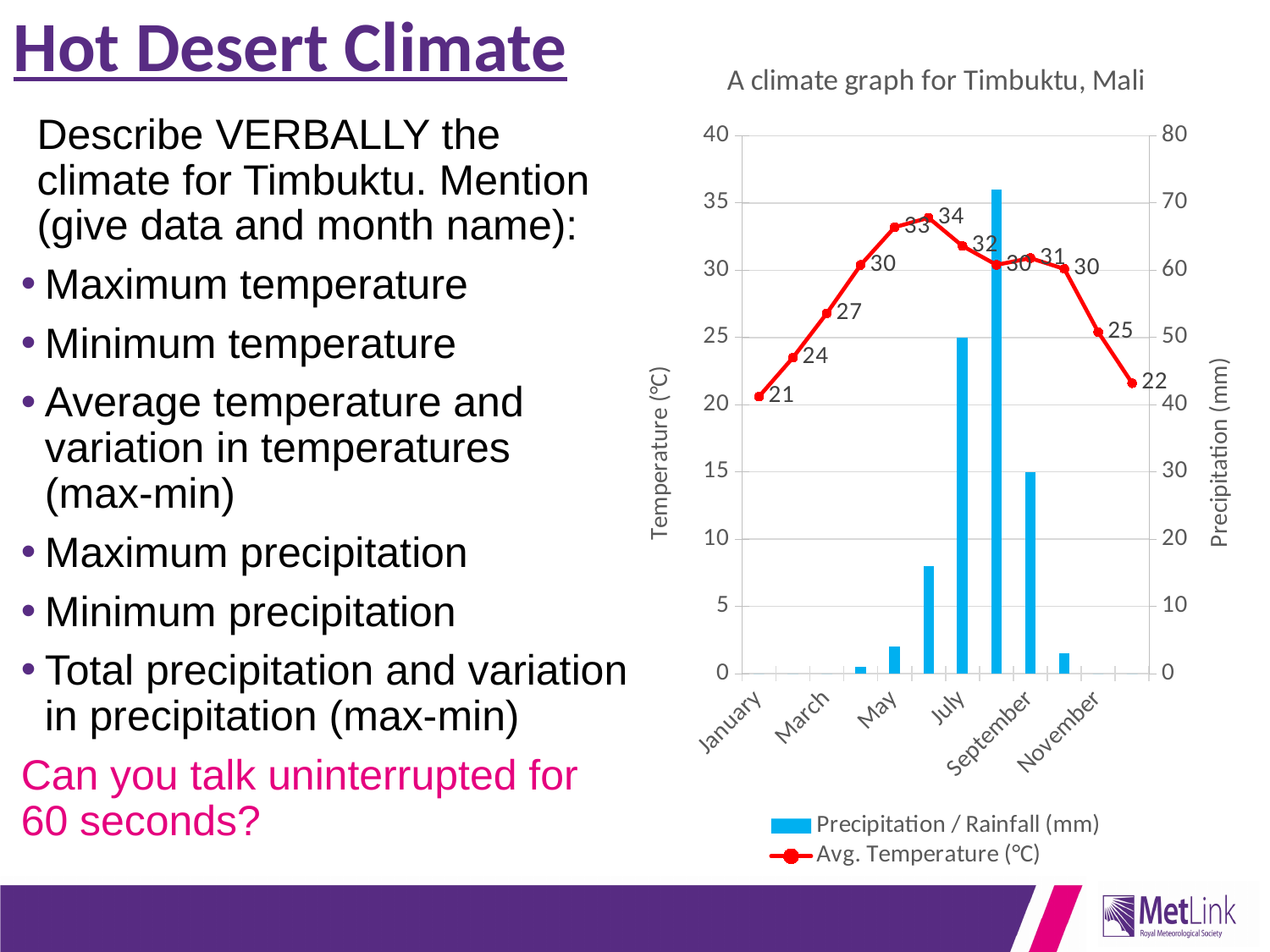
Which month has the lowest average temperature? January How many series does the legend list? 2 What is the average temperature for July? 32 What kind of chart is shown on the slide? A combined bar and line chart What is the difference between the average temperature in May and in January? 12 Does the average temperature rise or fall from January to May? rise Is the precipitation value for July greater or less than 40? greater Is the precipitation value for September greater or less than 20? greater What is the highest average temperature value labelled on the line? 34 What is the title of the chart? A climate graph for Timbuktu, Mali What is the average temperature for January? 21 Which has the higher average temperature, March or November? March